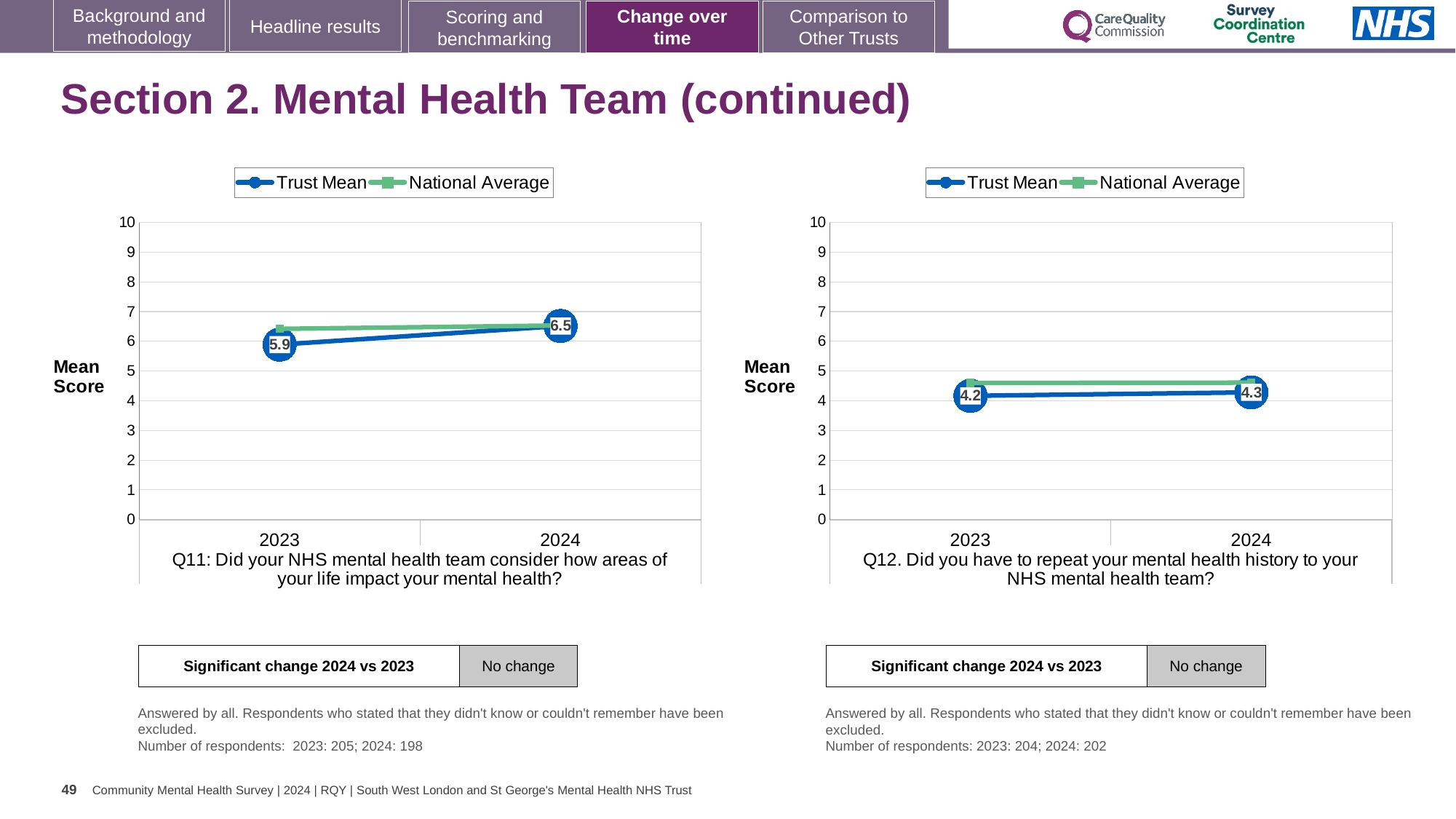
How many years are plotted on the x axis of the right chart (Q12)? 2 What type of chart is the right chart (Q12)? line chart In the right chart (Q12), what is the Trust Mean score for 2023? 4.2 In the left chart (Q11), does the Trust Mean rise or fall from 2023 to 2024? rise In the right chart (Q12), is the National Average for 2024 greater or less than 5? less How many series does the legend of the left chart (Q11) list? 2 In the right chart (Q12), which year has the higher Trust Mean score? 2024 In the right chart (Q12), what is the Trust Mean score for 2024? 4.3 In the left chart (Q11), is the National Average for 2023 greater or less than 6? greater In the left chart (Q11), what is the Trust Mean score for 2024? 6.5 In the left chart (Q11), by how much did the Trust Mean change from 2023 to 2024? 0.6 In the left chart (Q11), what is the Trust Mean score for 2023? 5.9